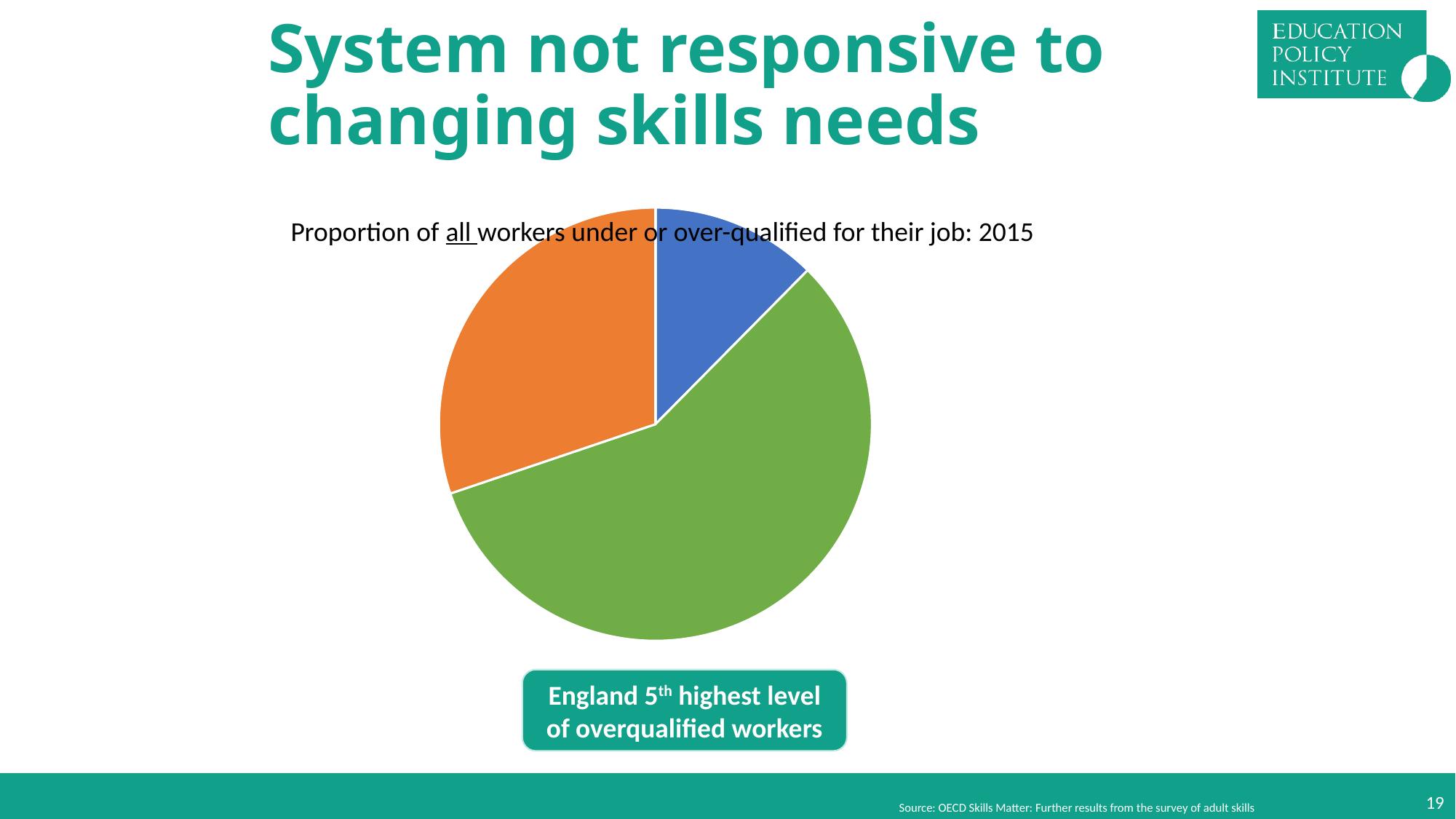
What kind of chart is shown on the slide? pie chart How many slices does the pie chart have? 3 What year does the pie chart's title refer to? 2015 What is the title of the pie chart? Proportion of all workers under or over-qualified for their job: 2015 Does the green slice take up more or less than half of the pie chart? more Which is larger in the pie chart, the orange slice or the blue slice? orange Does the blue slice take up more or less than a quarter of the pie chart? less Which colour slice is the smallest in the pie chart? blue Which is larger in the pie chart, the green slice or the orange slice? green Which colour slice is the largest in the pie chart? green